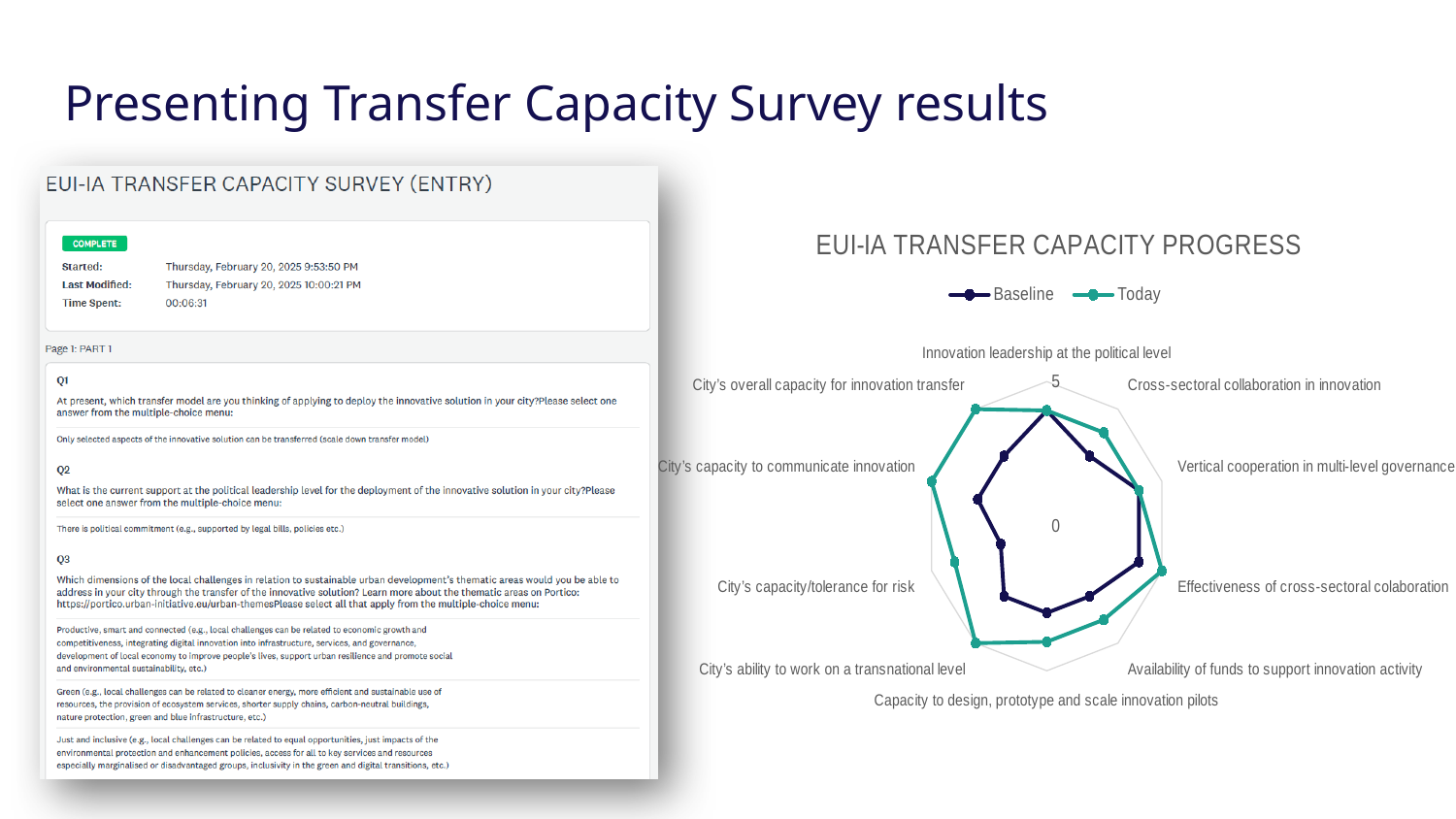
What are the two series named in the chart's legend? Baseline and Today For 'City's capacity to communicate innovation', which series has the larger value, Baseline or Today? Today For 'City's capacity/tolerance for risk', which series has the larger value, Baseline or Today? Today How many series does the chart's legend list? 2 What kind of chart is shown on the slide? Radar chart For 'City's ability to work on a transnational level', which series has the larger value, Baseline or Today? Today What is the maximum value shown on the radar chart's scale? 5 What is the title of the chart on the slide? EUI-IA TRANSFER CAPACITY PROGRESS How many categories (axes) does the radar chart have? 10